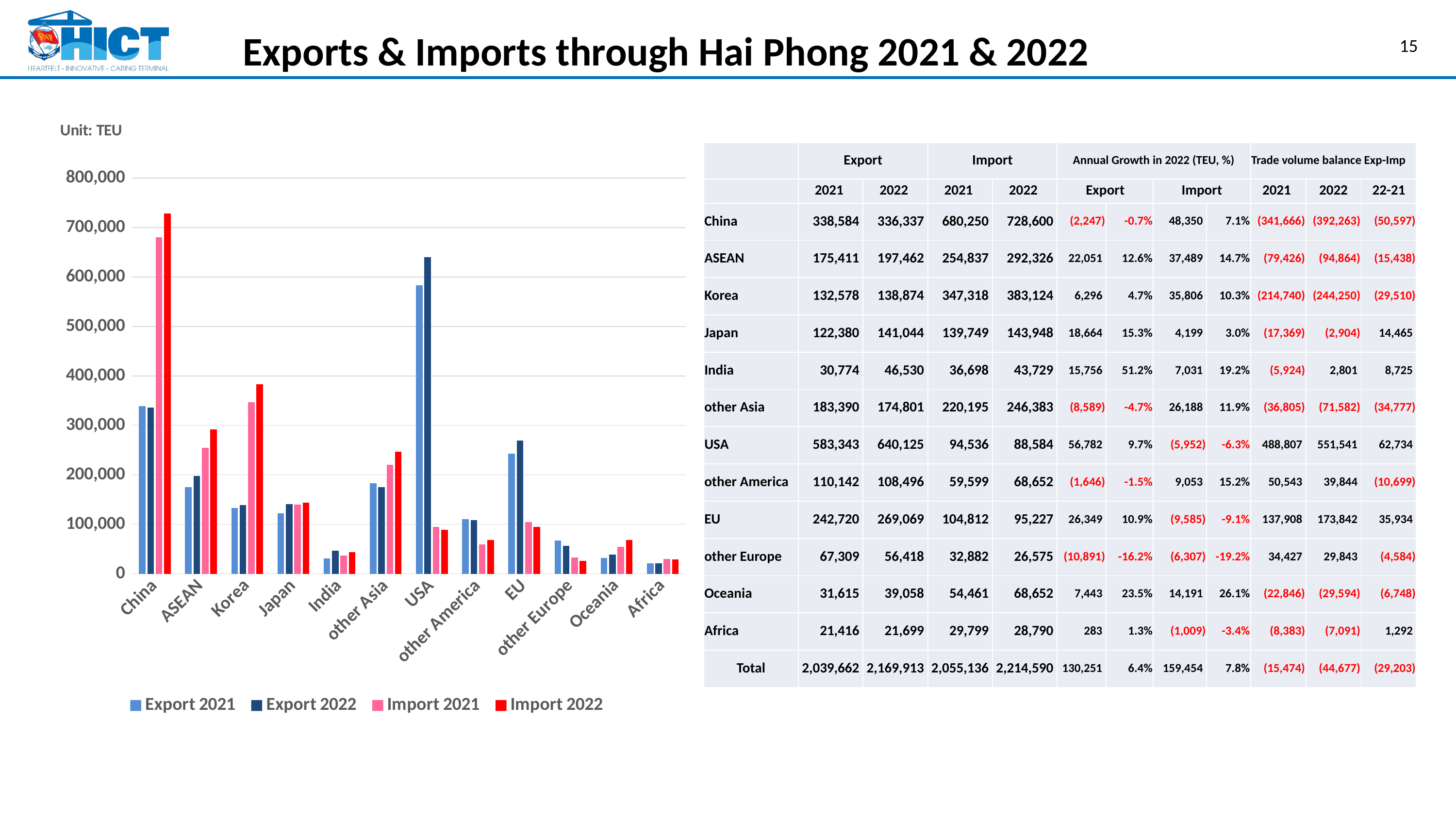
Is the Export 2021 value for USA greater or less than 500,000? greater What is the Export 2022 value for USA? 640,125 Which category has the highest Import 2022 value? China Which category has the lowest Export 2021 value? Africa How many categories are shown along the x axis of the chart? 12 For EU, which is larger: Export 2022 or Import 2022? Export 2022 What is the Import 2021 value for Japan? 139,749 How many series does the chart legend list? 4 By how much did China's imports increase from 2021 to 2022? 48,350 Is the Import 2021 value for Korea greater or less than 300,000? greater What unit is stated for the chart values? TEU What kind of chart is shown on the slide? bar chart